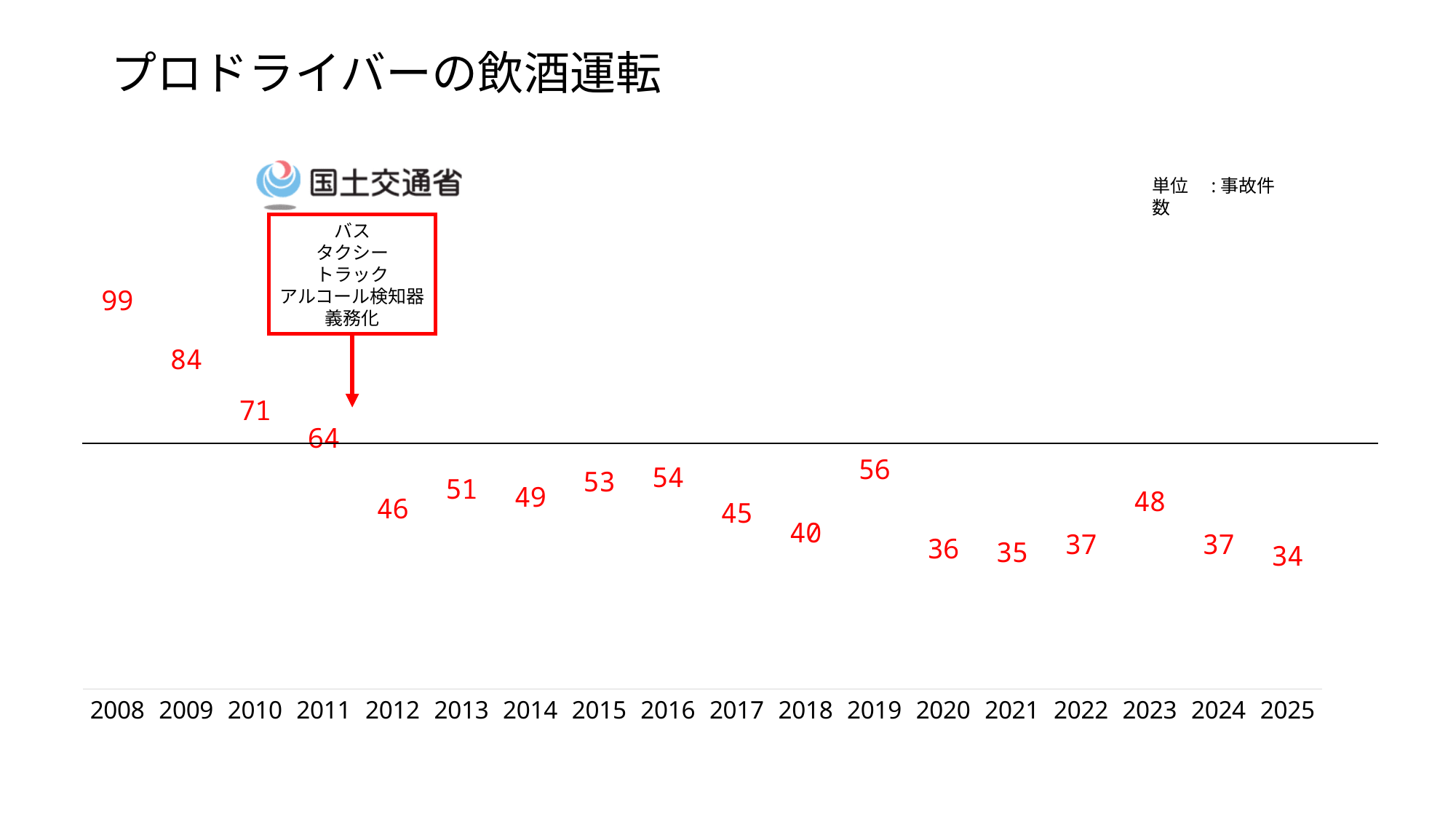
How many years are shown on the x axis? 18 What is the value for 2019? 56 What is the difference between the values for 2008 and 2009? 15 What is the value for 2025? 34 Which year has the highest value? 2008 What is the difference between the values for 2011 and 2012? 18 What is the value for 2011? 64 Which is larger, the value for 2016 or the value for 2017? 2016 What is the value for 2008? 99 What is the title of the slide? プロドライバーの飲酒運転 Which year has the lowest value? 2025 Do the values generally rise or fall from 2008 to 2025? fall